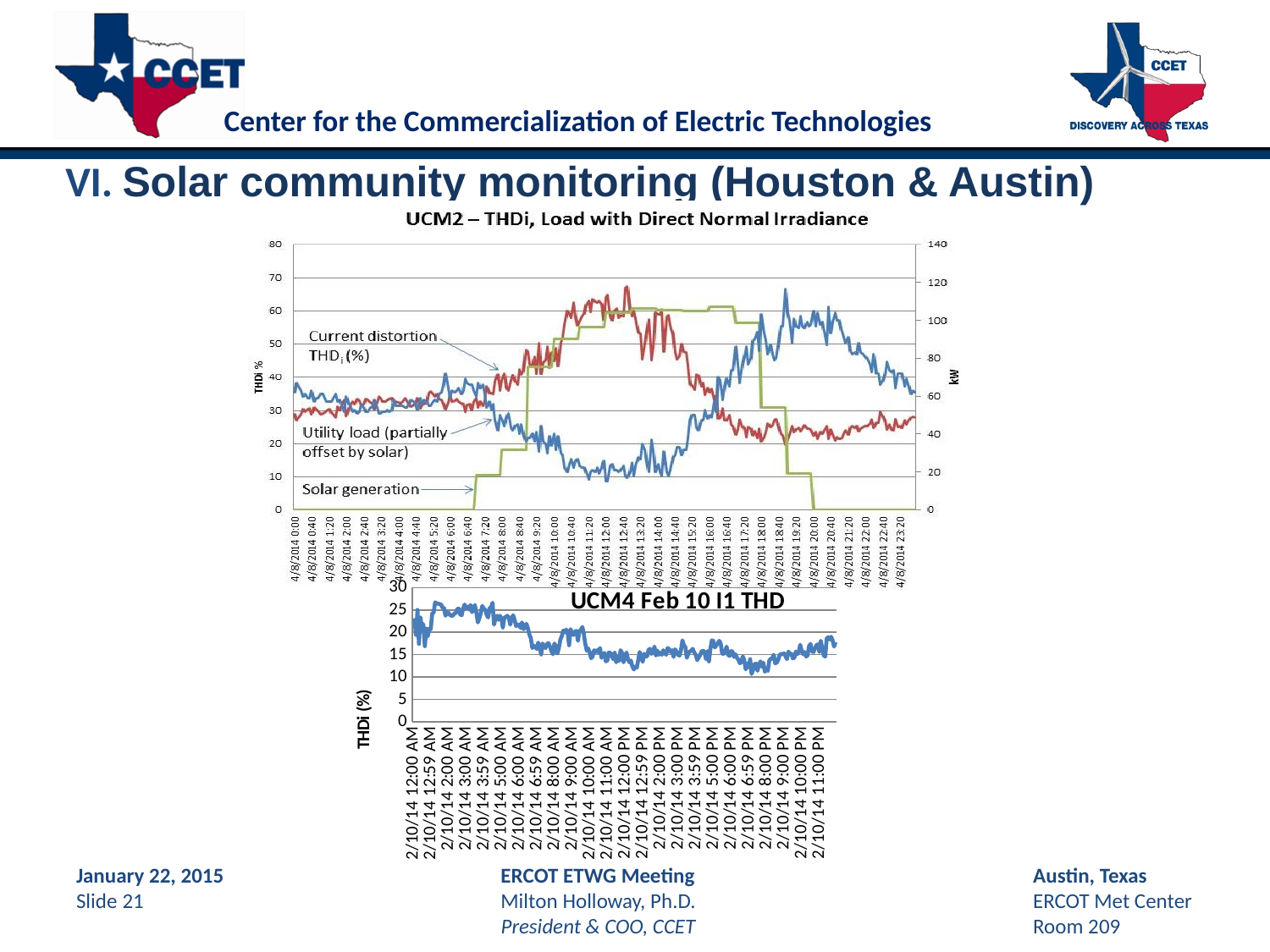
In the top chart 'UCM2 – THDi, Load with Direct Normal Irradiance', how many data series are plotted? 3 In the bottom chart 'UCM4 Feb 10 I1 THD', does the THDi value generally rise or fall from the start of the day to the end? fall In the top chart 'UCM2 – THDi, Load with Direct Normal Irradiance', is the solar generation value at 4/8/2014 2:00 greater or less than 20 kW? less What type of chart is the bottom chart titled 'UCM4 Feb 10 I1 THD'? line chart In the top chart 'UCM2 – THDi, Load with Direct Normal Irradiance', what unit is shown on the right-hand vertical axis? kW In the bottom chart 'UCM4 Feb 10 I1 THD', is the THDi value at 2/10/14 8:00 PM greater or less than 15? less In the bottom chart 'UCM4 Feb 10 I1 THD', is the THDi value at 2/10/14 12:00 PM greater or less than 20? less What is the label on the vertical axis of the bottom chart 'UCM4 Feb 10 I1 THD'? THDi (%) What type of chart is the top chart titled 'UCM2 – THDi, Load with Direct Normal Irradiance'? line chart